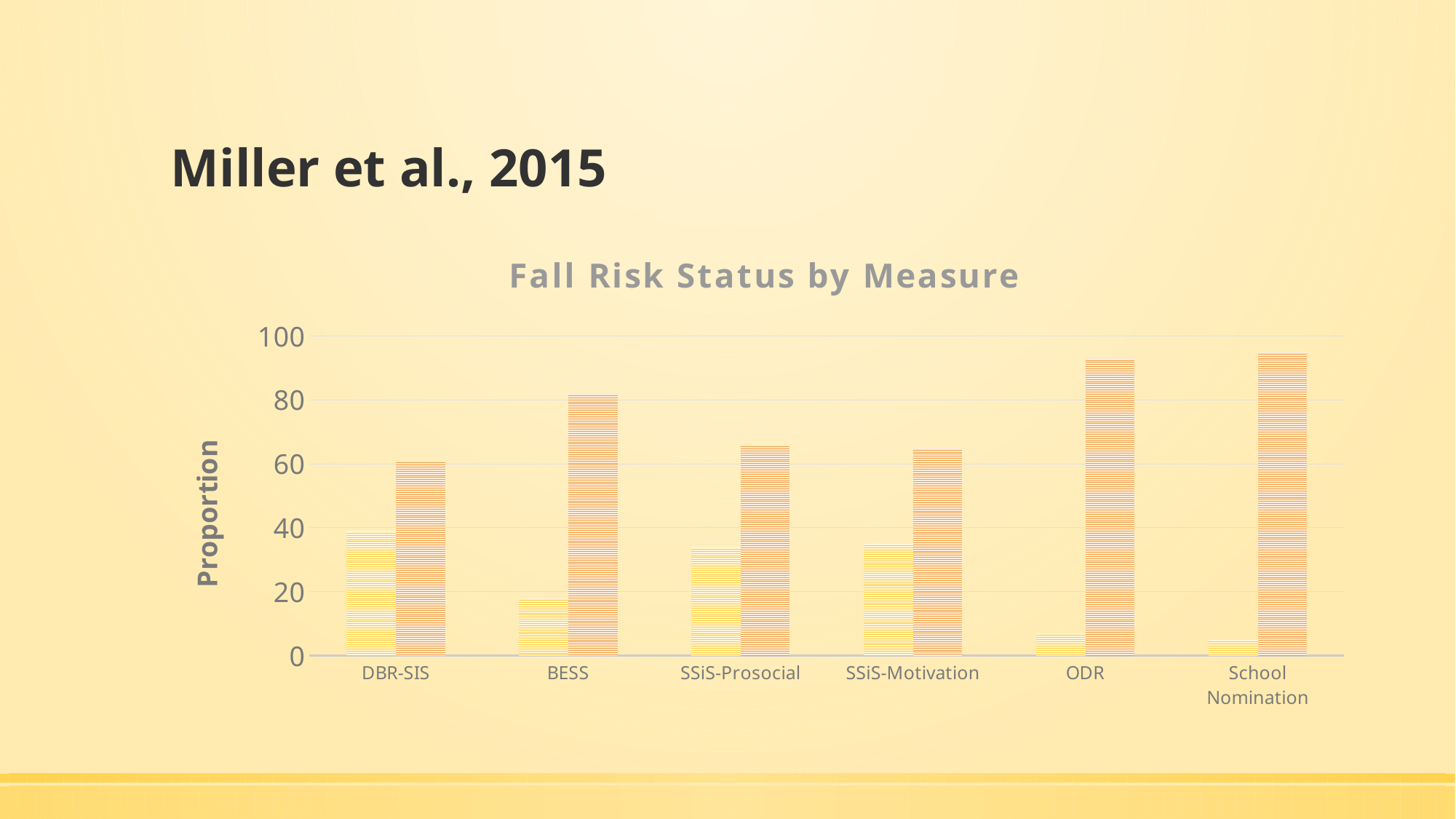
Is the orange bar for School Nomination greater or less than 80? greater What is the title of the chart? Fall Risk Status by Measure Is the orange bar for SSiS-Prosocial greater or less than 60? greater Is the orange bar for ODR greater or less than 80? greater Which is larger, the orange bar for BESS or the orange bar for DBR-SIS? BESS Which is larger, the yellow bar for DBR-SIS or the yellow bar for BESS? DBR-SIS How many measures (categories) are shown along the x axis? 6 What is the label on the vertical axis of the chart? Proportion What kind of chart is shown on the slide? bar chart How many bars are plotted for each measure? 2 Which measure has the tallest yellow bar? DBR-SIS